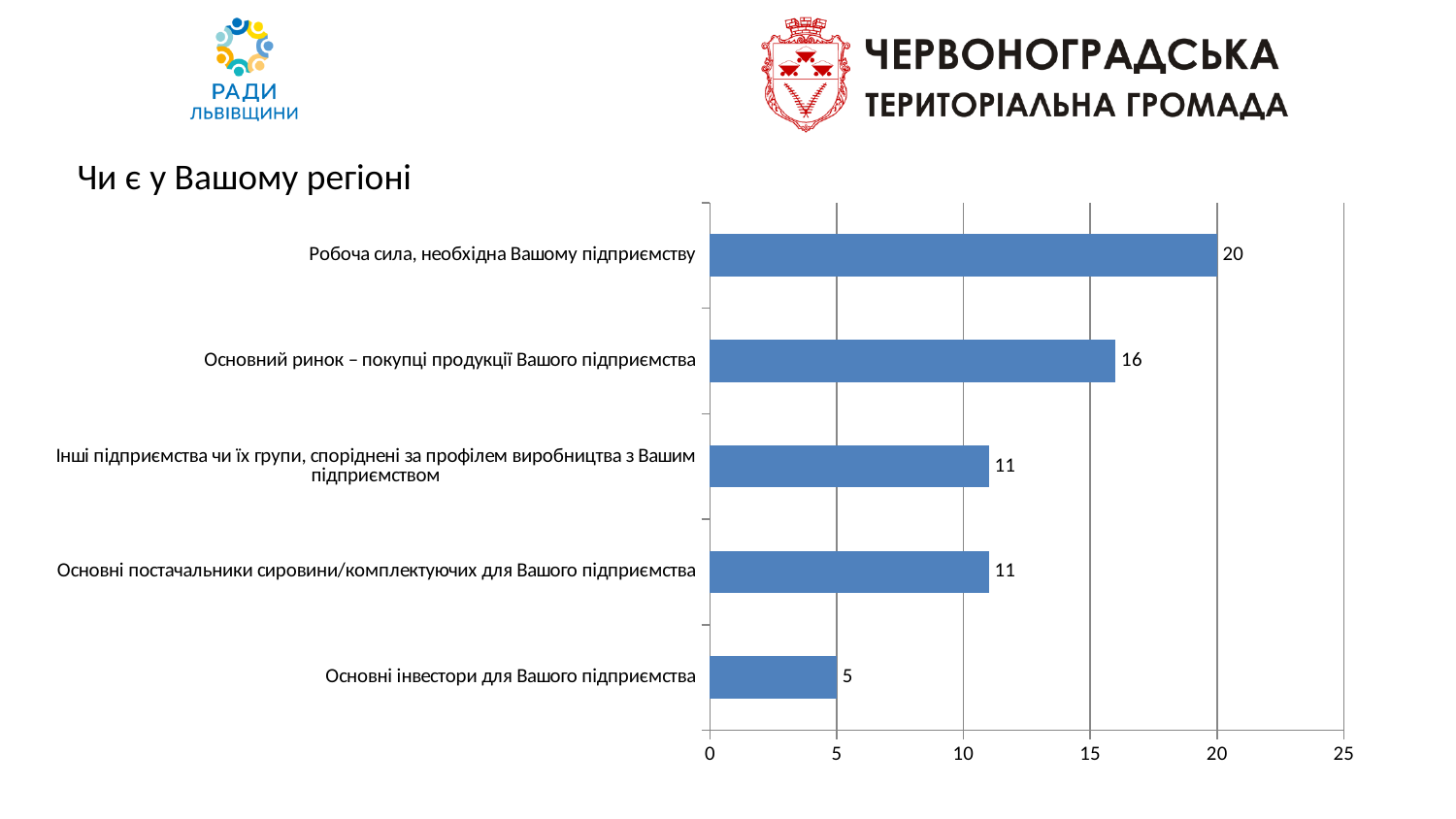
How many categories are shown in the chart? 5 What is the difference between the values for "Робоча сила, необхідна Вашому підприємству" and "Основні інвестори для Вашого підприємства"? 15 Is the value for "Основний ринок – покупці продукції Вашого підприємства" greater or less than 15? greater What kind of chart is shown on the slide? bar chart Which category has the highest value? Робоча сила, необхідна Вашому підприємству What is the difference between the values for "Основний ринок – покупці продукції Вашого підприємства" and "Основні постачальники сировини/комплектуючих для Вашого підприємства"? 5 What is the value for "Робоча сила, необхідна Вашому підприємству"? 20 What is the title of the chart? Чи є у Вашому регіоні What is the value for "Основні інвестори для Вашого підприємства"? 5 What is the value for "Основний ринок – покупці продукції Вашого підприємства"? 16 Which is larger: the value for "Основний ринок – покупці продукції Вашого підприємства" or for "Основні постачальники сировини/комплектуючих для Вашого підприємства"? Основний ринок – покупці продукції Вашого підприємства Which category has the lowest value? Основні інвестори для Вашого підприємства